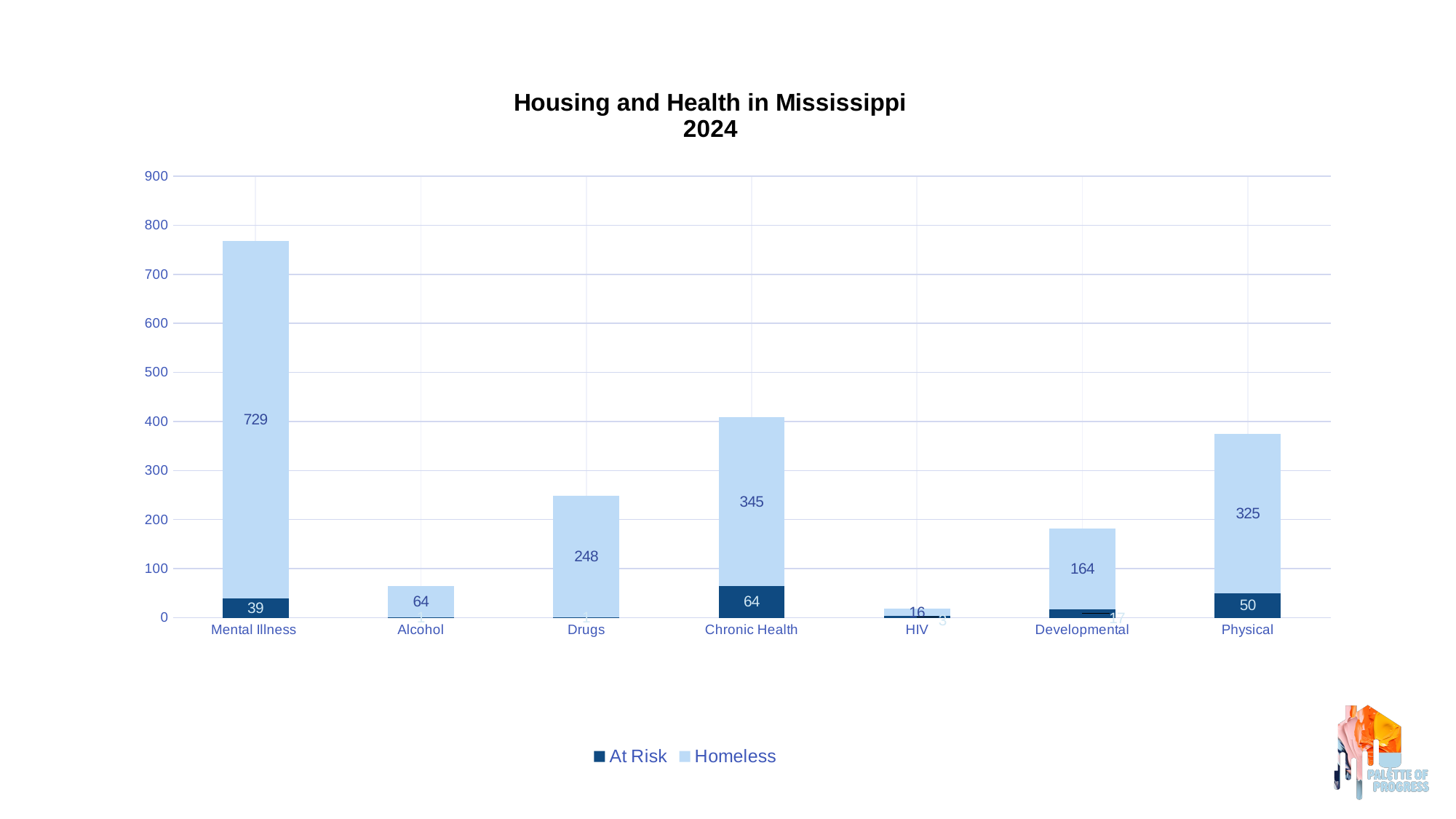
How many categories are shown on the x axis? 7 Is the Homeless value for Developmental larger than the Homeless value for Alcohol? Yes What is the At Risk value for Chronic Health? 64 How many series does the legend list? 2 What is the difference between the Homeless values for Chronic Health and Drugs? 97 Which category has the highest Homeless value? Mental Illness What is the Homeless value for Mental Illness? 729 Which category has the lowest Homeless value? HIV What is the Homeless value for Physical? 325 What is the title of the chart? Housing and Health in Mississippi 2024 What is the total of the stacked bar for Physical? 375 What type of chart is shown on the slide? Stacked bar chart